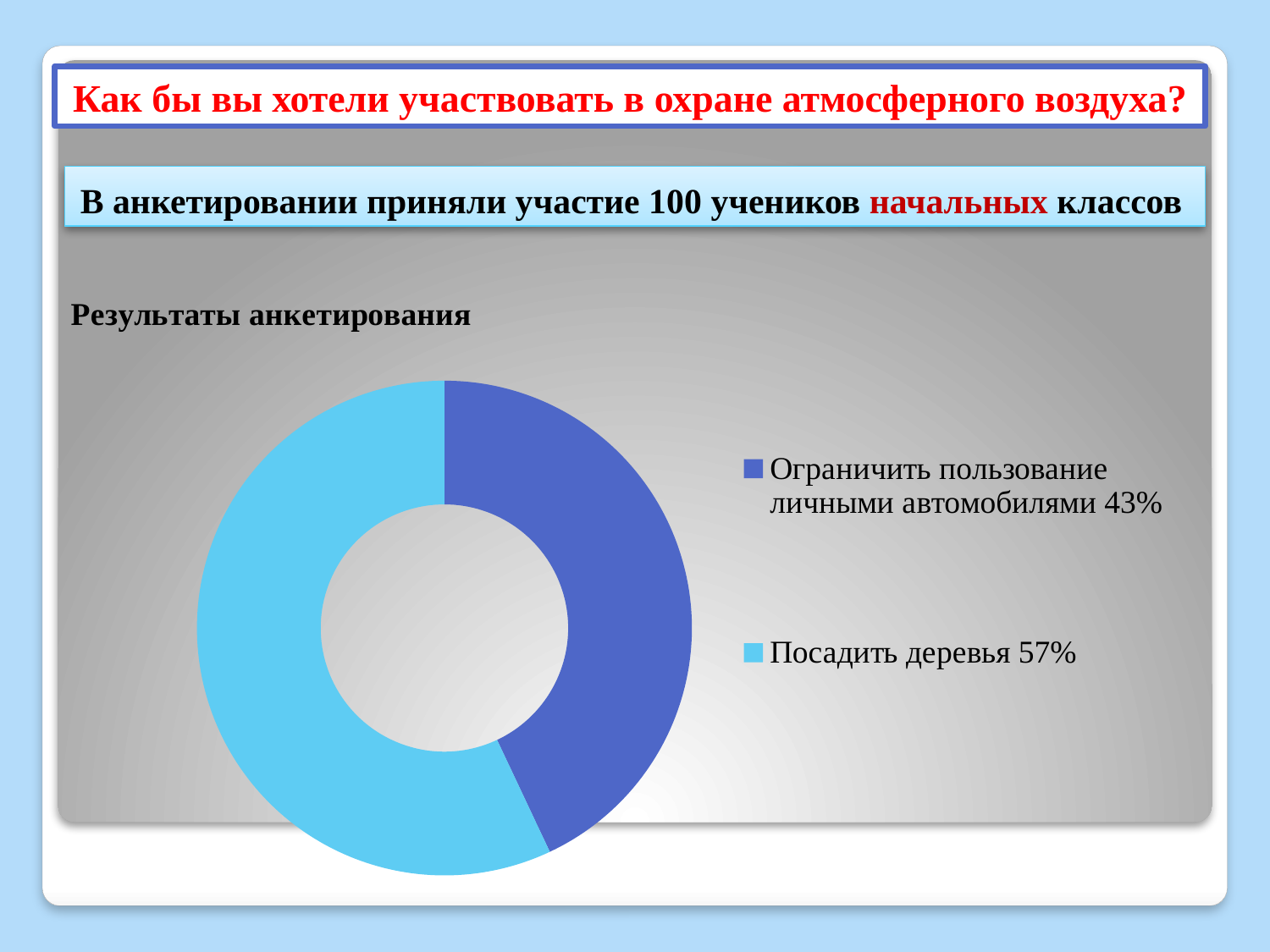
Which category has the largest share? Посадить деревья What is the difference in percentage points between "Посадить деревья" and "Ограничить пользование личными автомобилями"? 14 How many categories does the chart show? 2 What share of respondents chose "Ограничить пользование личными автомобилями"? 43% What kind of chart is shown on the slide? Doughnut chart What is the title of the chart? Результаты анкетирования What share of respondents chose "Посадить деревья"? 57% Which is larger: the share for "Посадить деревья" or for "Ограничить пользование личными автомобилями"? Посадить деревья What is the total of the two shares shown in the chart? 100% Which category has the smallest share? Ограничить пользование личными автомобилями What colour represents "Посадить деревья" in the chart? Light blue